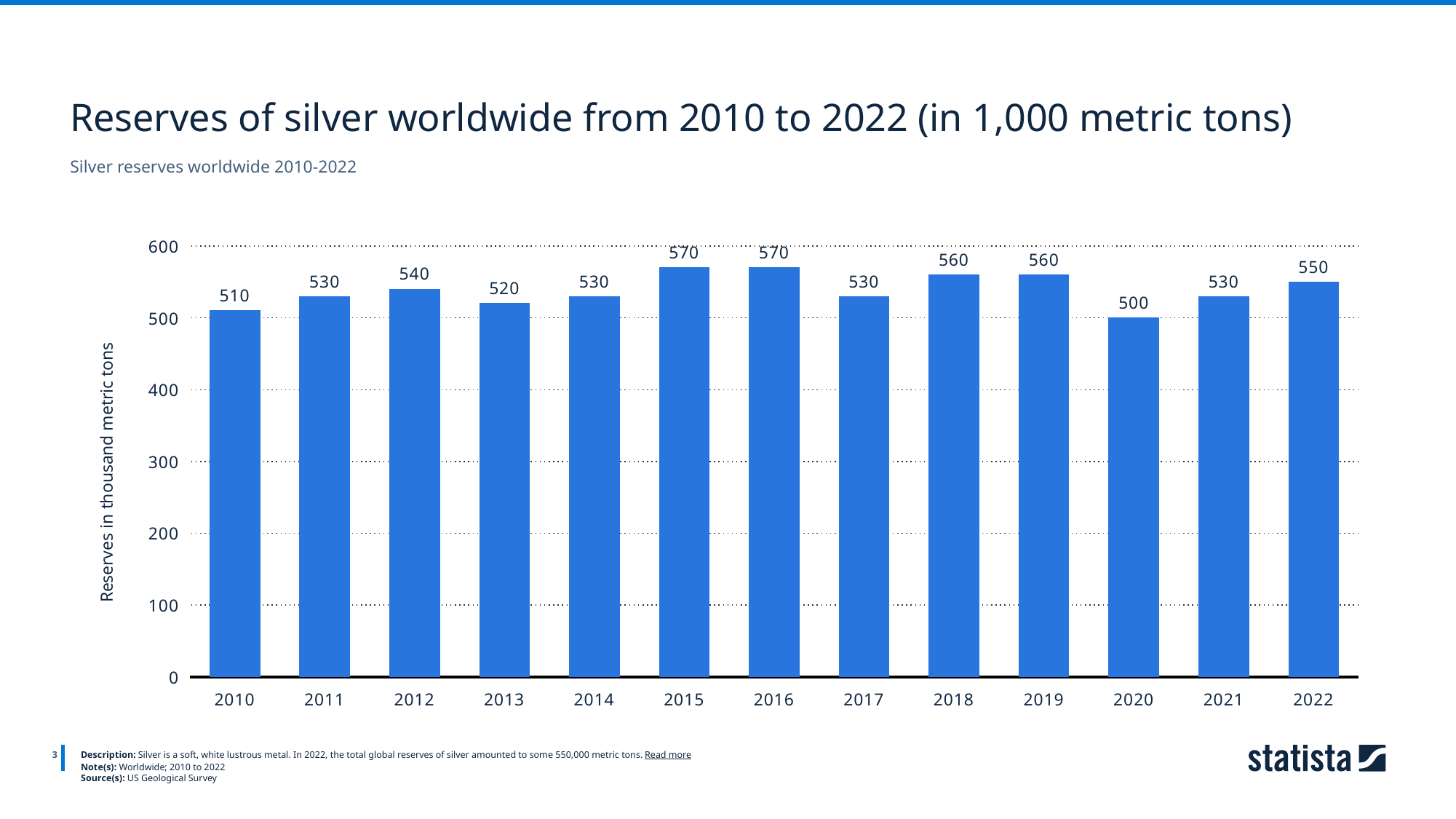
How many years are shown on the x axis? 13 What is the value for 2018? 560 What is the highest value shown on the chart? 570 What is the value for 2022? 550 What is the value for 2010? 510 What is the difference between the values for 2022 and 2010? 40 Is the value for 2015 greater or less than 500? greater Which is larger, the value for 2012 or the value for 2013? 2012 What kind of chart is shown on the slide? bar chart What is the label of the y axis? Reserves in thousand metric tons What is the difference between the values for 2016 and 2020? 70 Which year has the lowest value? 2020